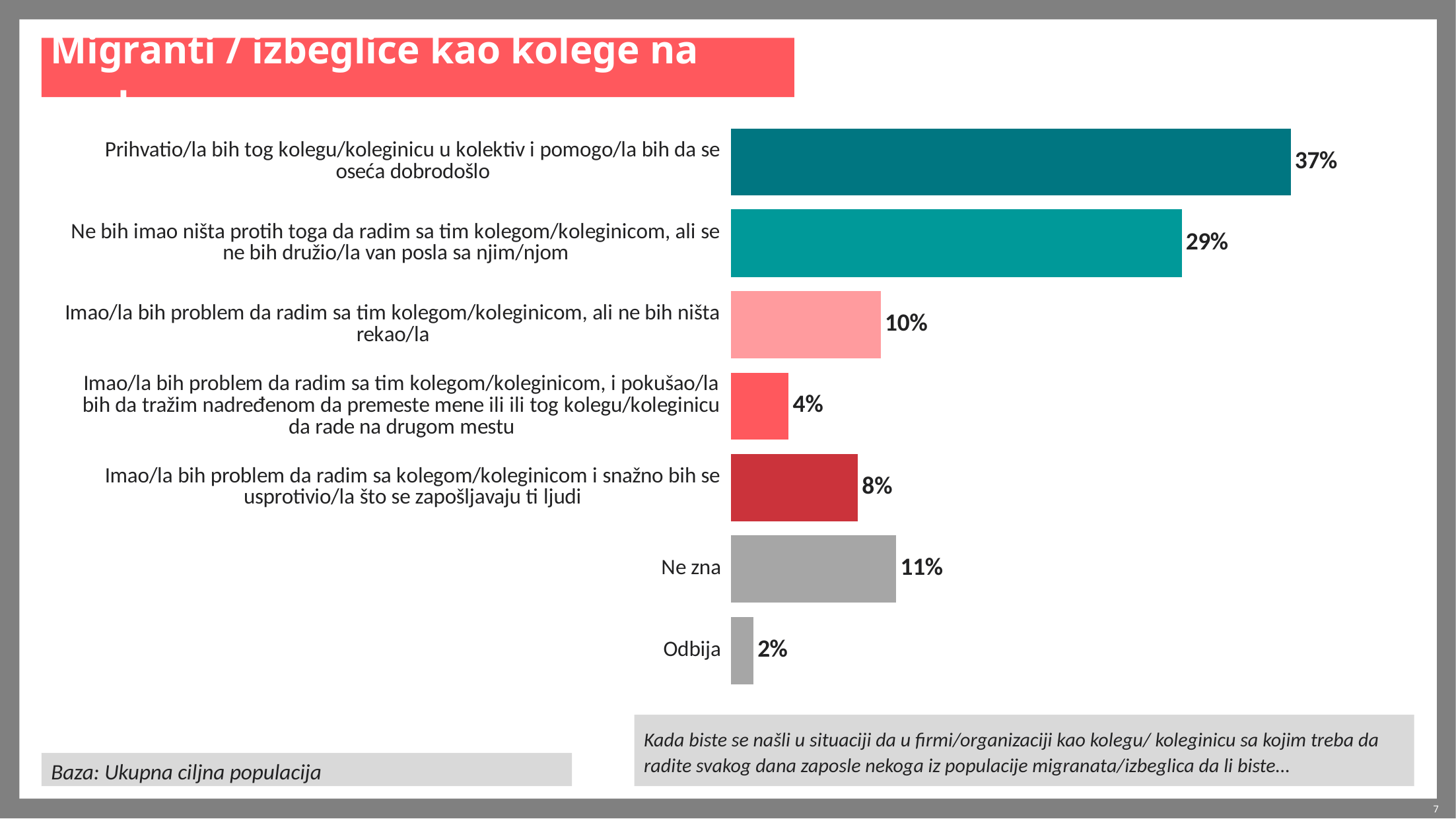
What percentage is shown for 'Odbija'? 2% What is the value for 'Prihvatio/la bih tog kolegu/koleginicu u kolektiv i pomogo/la bih da se oseća dobrodošlo'? 37% Which is larger: the value for 'Ne zna' or the value for 'Imao/la bih problem da radim sa tim kolegom/koleginicom, ali ne bih ništa rekao/la'? Ne zna Which category has the highest value? Prihvatio/la bih tog kolegu/koleginicu u kolektiv i pomogo/la bih da se oseća dobrodošlo What kind of chart is shown on the slide? Bar chart What percentage is shown for 'Ne zna'? 11% What colour is the bar for 'Ne zna'? Grey Which category has the lowest value? Odbija What is the value for 'Imao/la bih problem da radim sa tim kolegom/koleginicom, ali ne bih ništa rekao/la'? 10% How many categories are shown in the chart? 7 What is the difference between the value for 'Imao/la bih problem da radim sa kolegom/koleginicom i snažno bih se usprotivio/la što se zapošljavaju ti ljudi' and the value for 'Odbija'? 6% What is the difference between the value for 'Prihvatio/la bih tog kolegu/koleginicu u kolektiv i pomogo/la bih da se oseća dobrodošlo' and 'Ne bih imao ništa protih toga da radim sa tim kolegom/koleginicom, ali se ne bih družio/la van posla sa njim/njom'? 8%